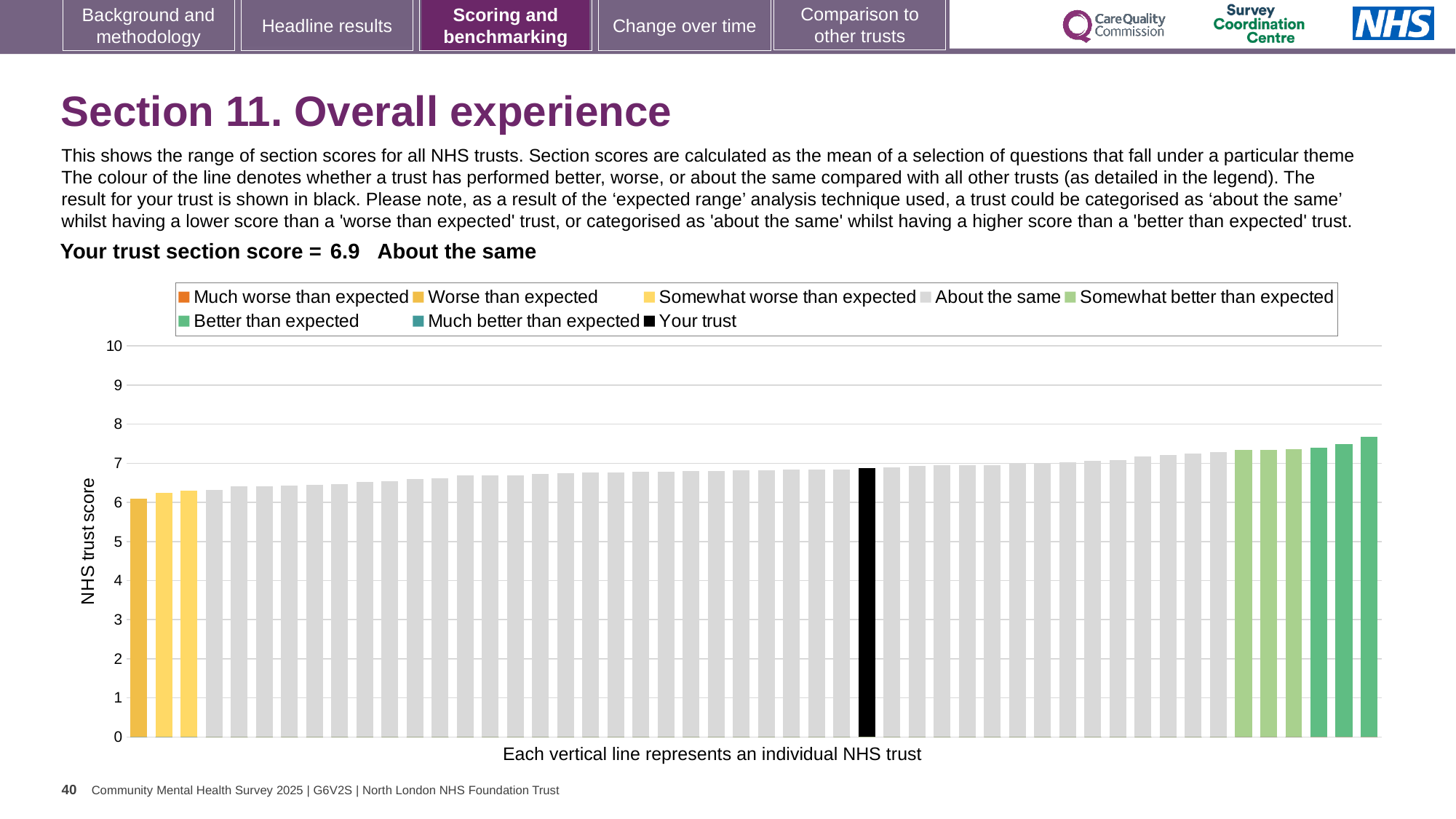
What is the highest value shown on the vertical axis? 10 What is the section score for your trust? 6.9 Is the value for your trust (the black bar) greater or less than 6? greater Is the value of the shortest bar greater or less than 7? less What kind of chart is shown on the slide? bar chart How many entries does the chart legend list? 8 What is the title of the vertical axis? NHS trust score Is the value of the tallest bar greater or less than 7? greater What colour is the bar representing your trust? black Do the bar values rise or fall from left to right along the x axis? rise Which category is your trust's section score placed in? About the same